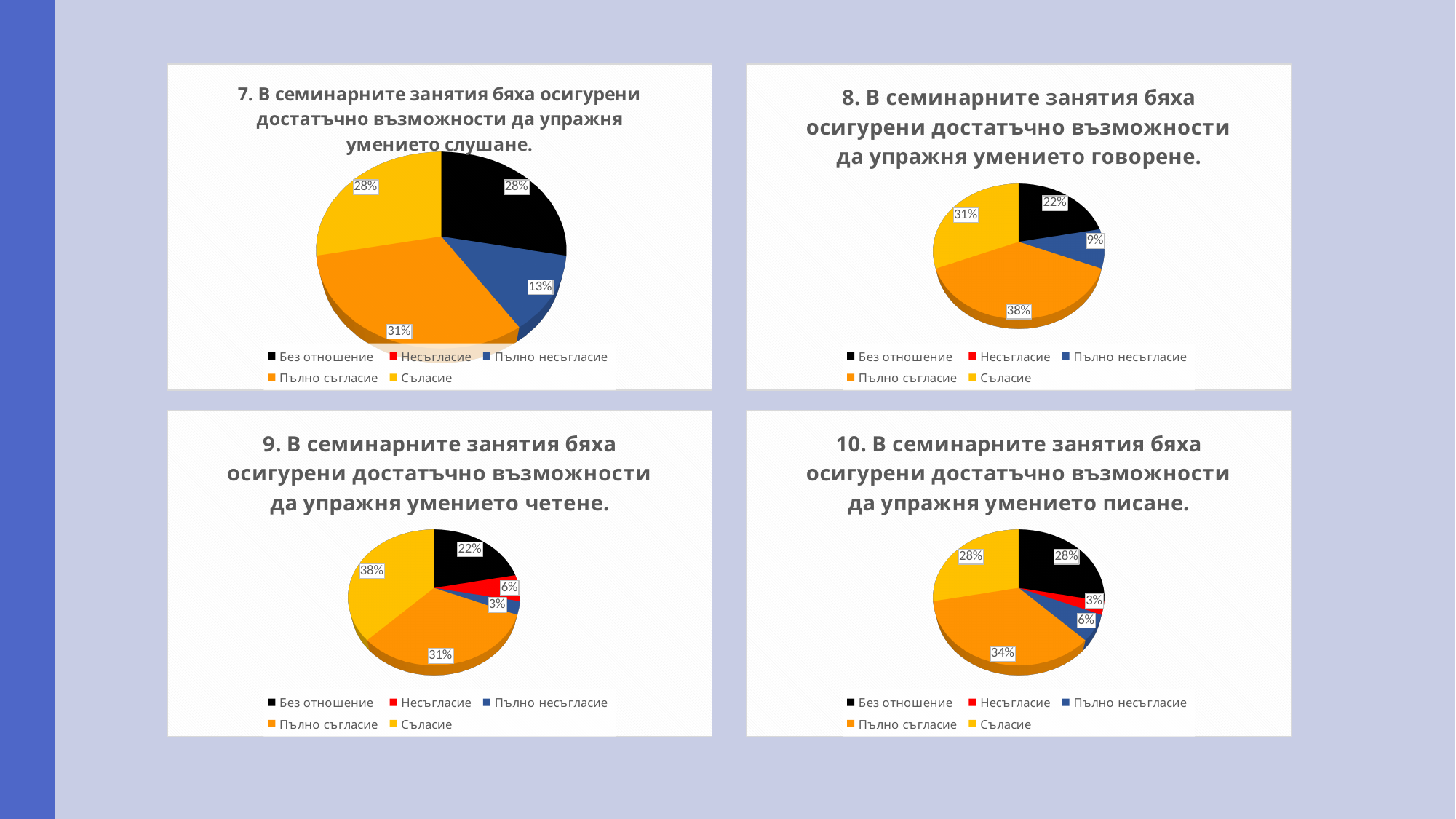
In the top-right chart (8, умението говорене), which category has the largest slice? Пълно съгласие In the bottom-right chart (10, умението писане), what is the difference between the Пълно съгласие slice and the Без отношение slice? 6% In the bottom-left chart (9, умението четене), which is larger: Несъгласие or Пълно несъгласие? Несъгласие In the top-right chart (8, умението говорене), what share of the pie is Без отношение? 22% In the bottom-right chart (10, умението писане), what share of the pie is Пълно съгласие? 34% In the bottom-left chart (9, умението четене), what share of the pie is Съгласие? 38% In the top-right chart (8, умението говорене), what is the difference between the Пълно съгласие slice and the Пълно несъгласие slice? 29% In the bottom-left chart (9, умението четене), which category has the smallest slice? Пълно несъгласие How many entries does the legend of the top-left chart (7, умението слушане) list? 5 In the top-left chart (7, умението слушане), what share of the pie is Пълно съгласие? 31% In the top-left chart (7, умението слушане), what share of the pie is Пълно несъгласие? 13% What kind of chart is used in the bottom-right chart (10, умението писане)? Pie chart